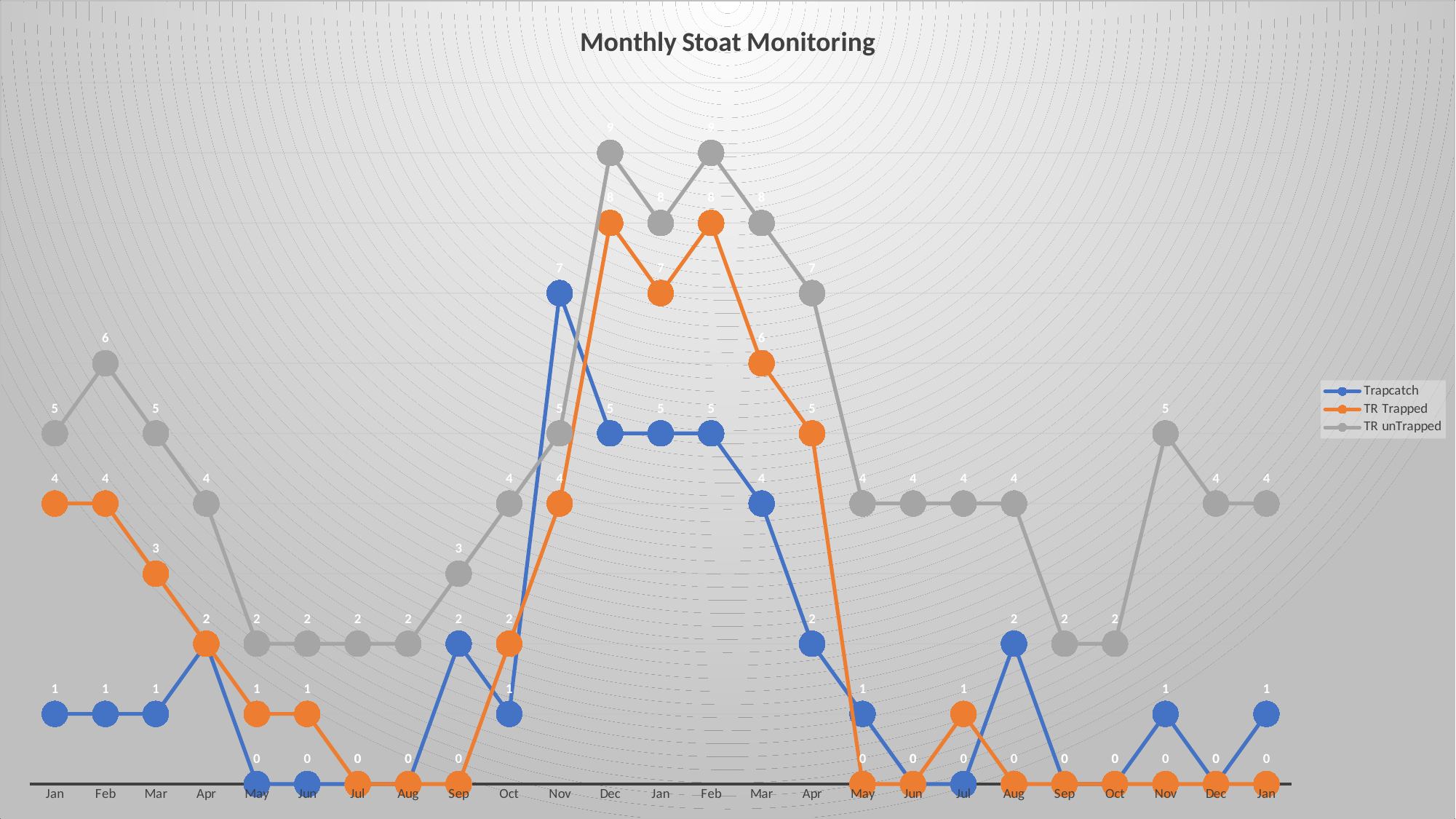
Does the TR unTrapped series rise or fall from the second Feb to the second May? fall At the first Dec, what is the difference between the TR unTrapped value and the Trapcatch value? 4 How many series does the legend list? 3 In which month does the Trapcatch series reach its highest value? Nov (the first Nov) At the first Feb, which is larger: TR Trapped or Trapcatch? TR Trapped What is the title of the chart? Monthly Stoat Monitoring What kind of chart is shown on the slide? line chart What is the TR unTrapped value for the first Dec on the x axis? 9 What is the TR Trapped value for the second Jul on the x axis? 1 What is the highest value reached by the TR unTrapped series? 9 How many monthly points are plotted along the x axis? 25 What is the Trapcatch value for the first Nov on the x axis? 7